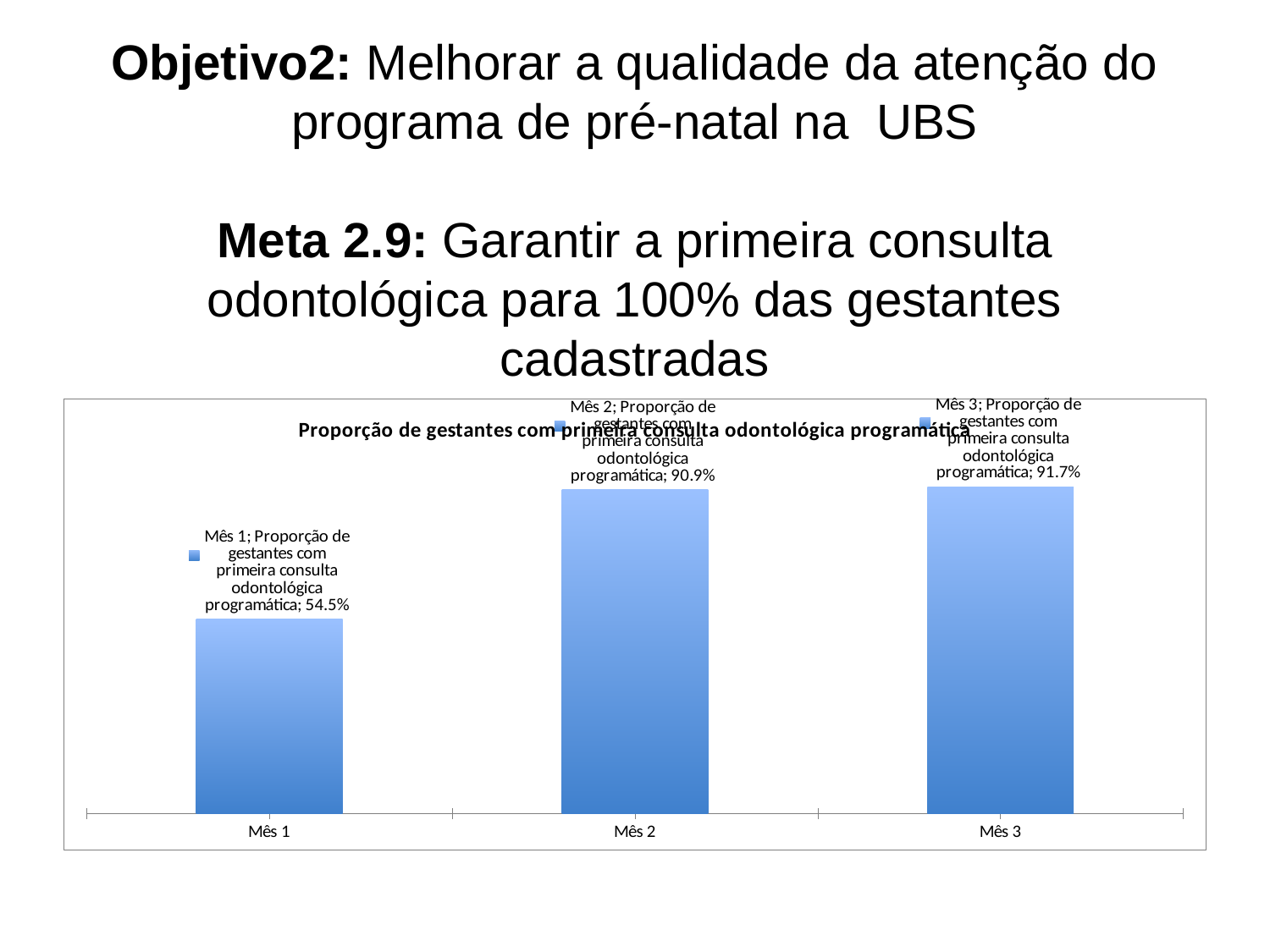
What is the difference between the values for Mês 3 and Mês 2? 0.8 percentage points What is the difference between the values for Mês 2 and Mês 1? 36.4 percentage points What is the value for Mês 2 in the chart? 90.9% Which is larger, the value for Mês 1 or the value for Mês 2? Mês 2 What kind of chart is shown on the slide? Bar chart What is the value for Mês 3 in the chart? 91.7% Do the values rise or fall from Mês 1 to Mês 3? Rise What is the title of the chart? Proporção de gestantes com primeira consulta odontológica programática Which month has the highest proportion in the chart? Mês 3 What is the value for Mês 1 in the chart? 54.5% Which month has the lowest proportion in the chart? Mês 1 How many months (categories) are shown in the chart? 3